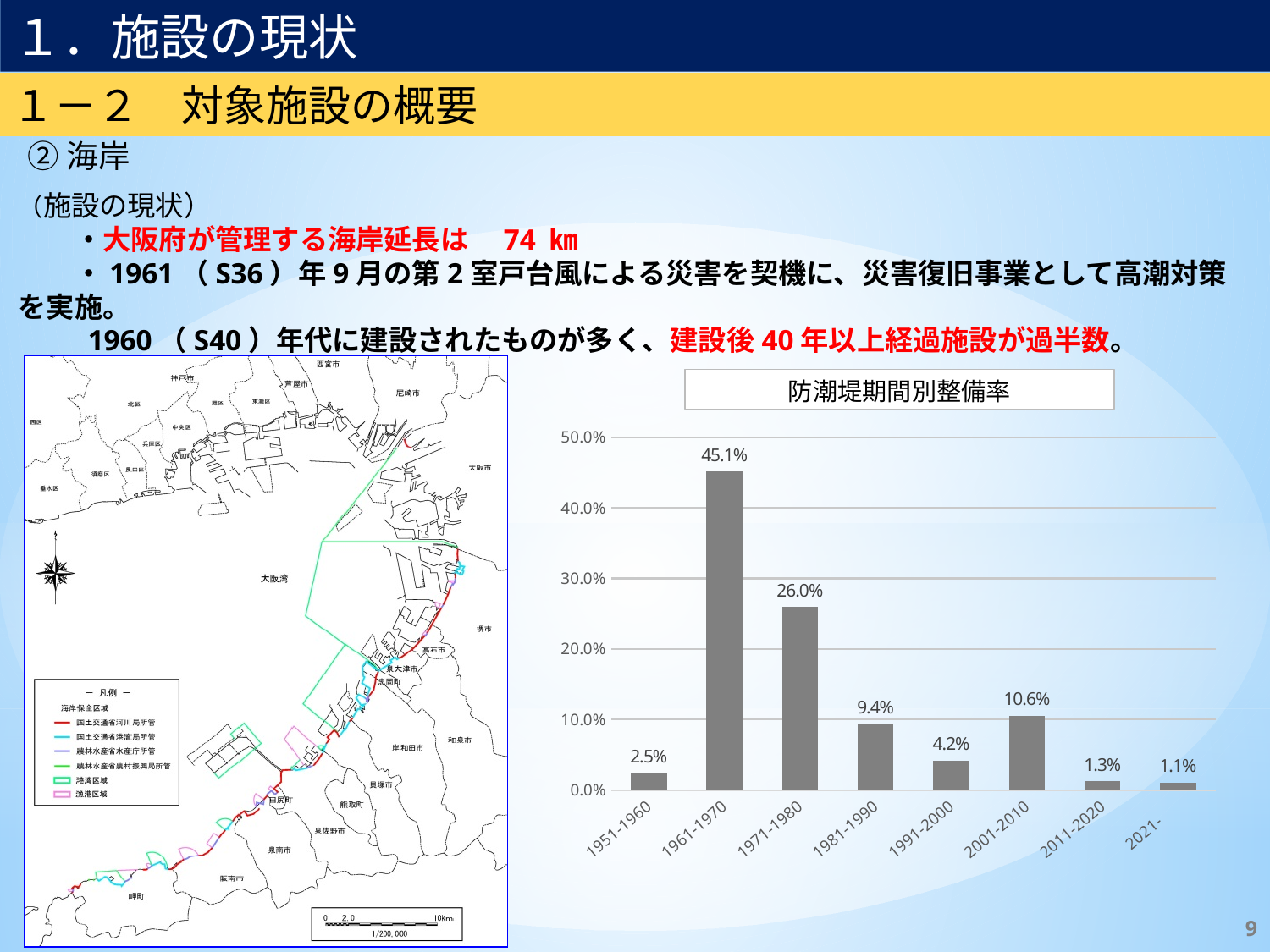
What is the value for 1971-1980 in the 防潮堤期間別整備率 chart? 26.0% Is the value for 1971-1980 in the 防潮堤期間別整備率 chart greater or less than 20.0%? greater What kind of chart is the 防潮堤期間別整備率 chart? bar chart Do the values in the 防潮堤期間別整備率 chart rise or fall from 1971-1980 to 1991-2000? fall Which is larger in the 防潮堤期間別整備率 chart, the value for 1981-1990 or the value for 2001-2010? 2001-2010 What is the value for 1961-1970 in the 防潮堤期間別整備率 chart? 45.1% How many periods are shown on the x axis of the 防潮堤期間別整備率 chart? 8 Which period has the lowest value in the 防潮堤期間別整備率 chart? 2021- What is the title of the chart on the right side of the slide? 防潮堤期間別整備率 Which period has the highest value in the 防潮堤期間別整備率 chart? 1961-1970 What is the value for 2001-2010 in the 防潮堤期間別整備率 chart? 10.6% What is the difference between the values for 1961-1970 and 1971-1980 in the 防潮堤期間別整備率 chart? 19.1%